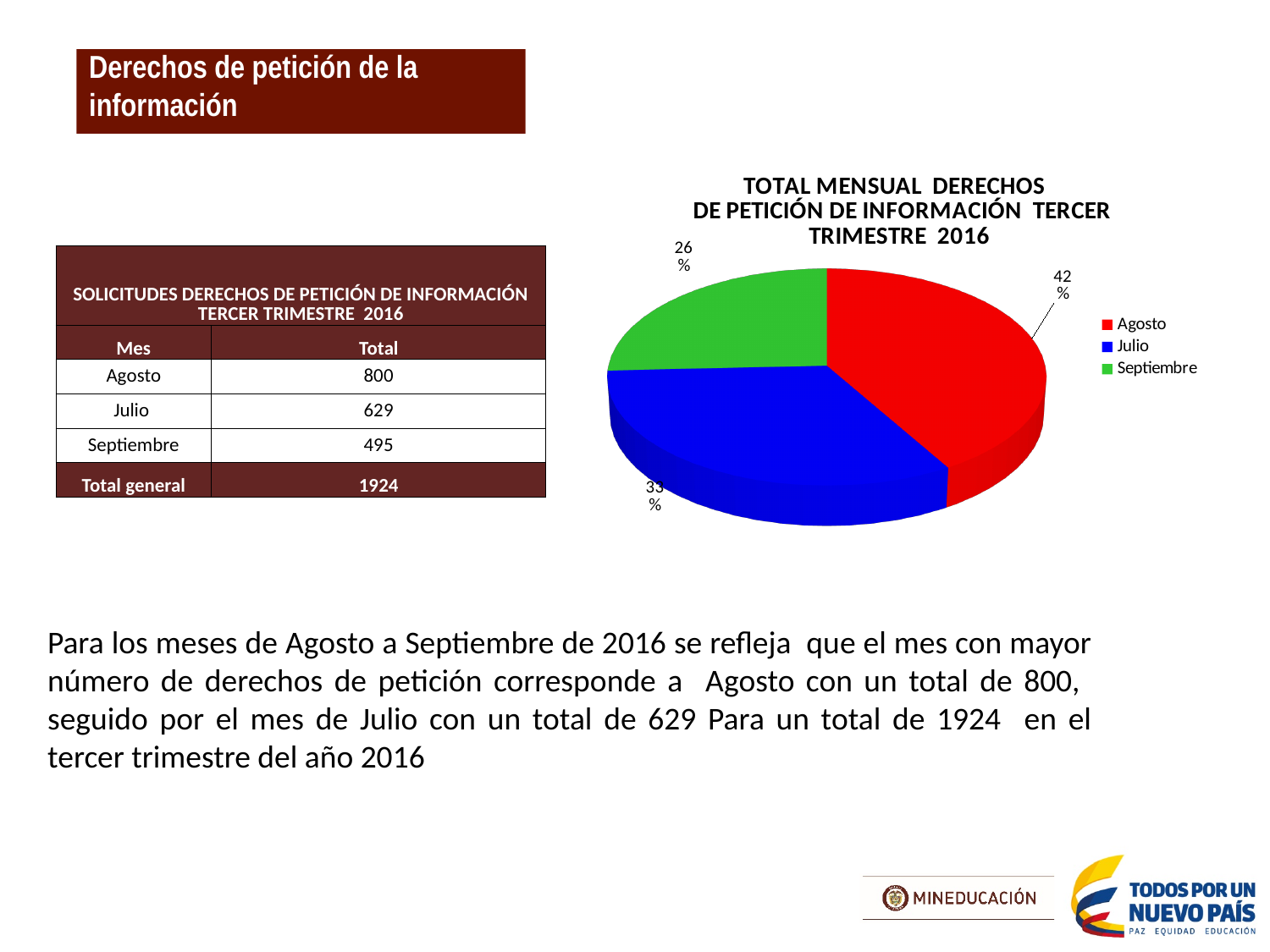
What is the difference in percentage points between the Agosto slice and the Septiembre slice? 16 What is the title of the pie chart? TOTAL MENSUAL DERECHOS DE PETICIÓN DE INFORMACIÓN TERCER TRIMESTRE 2016 What share of the pie does Septiembre represent? 26% What kind of chart is shown on the slide? pie chart Which month has the largest slice of the pie? Agosto How many entries does the legend of the pie chart list? 3 What colour is the Julio slice in the pie chart? blue Which month has the smallest slice of the pie? Septiembre What share of the pie does Julio represent? 33% Which slice is larger, Julio or Septiembre? Julio How many slices does the pie chart have? 3 What share of the pie does Agosto represent? 42%